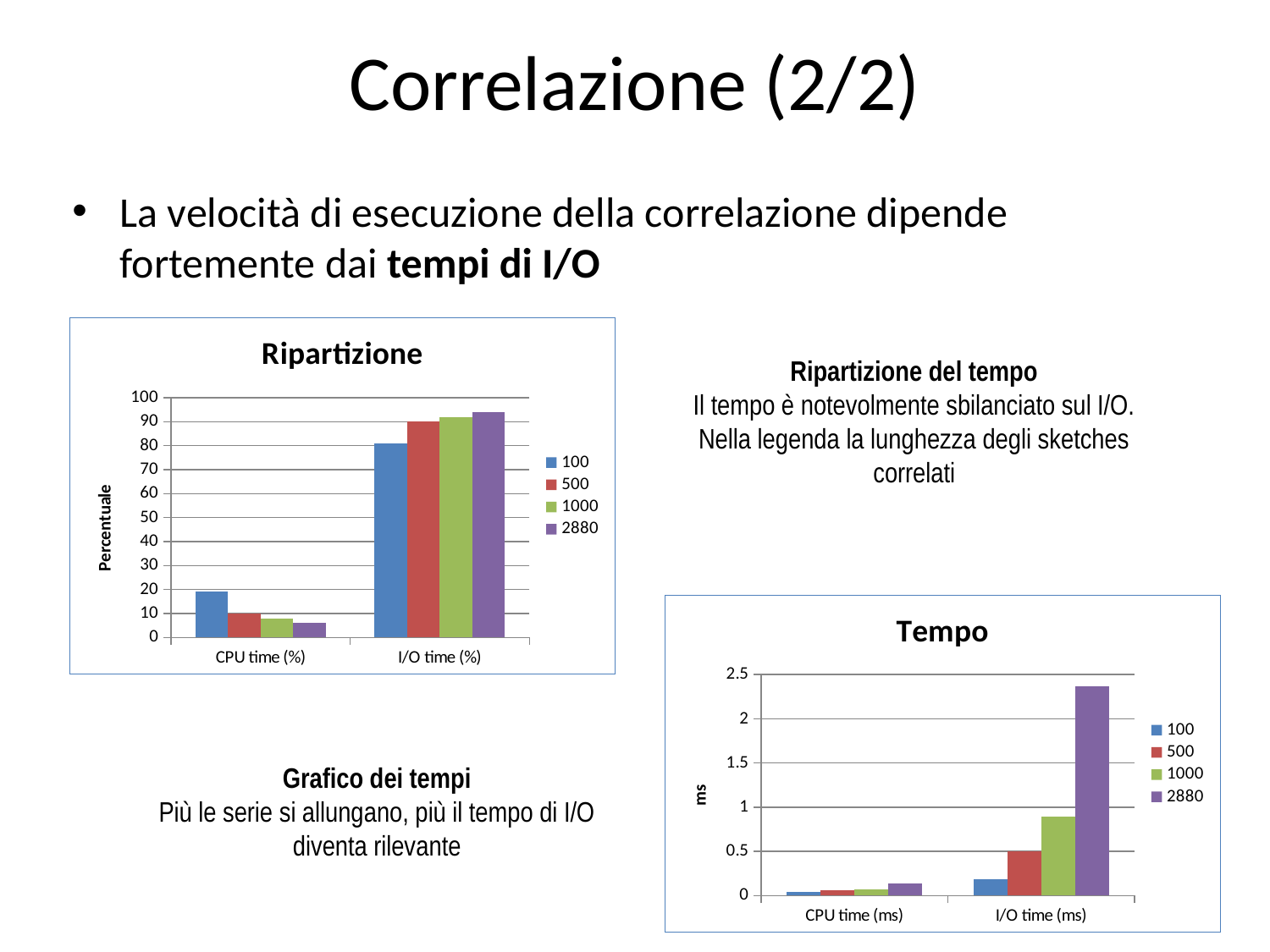
In the "Tempo" chart, is the value of the 2880 series for I/O time (ms) greater or less than 2? greater In the "Ripartizione" chart, which series has the lowest value for I/O time (%)? 100 In the "Ripartizione" chart, what is the label of the y axis? Percentuale In the "Ripartizione" chart, which series has the highest value for CPU time (%)? 100 In the "Ripartizione" chart, is the value of the 2880 series for I/O time (%) greater or less than 90? greater In the "Tempo" chart, what is the label of the y axis? ms In the "Tempo" chart, is the value of the 500 series for I/O time (ms) larger than the value of the 100 series for I/O time (ms)? Yes In the "Tempo" chart, which series has the highest value for I/O time (ms)? 2880 In the "Ripartizione" chart, how many series does the legend list? 4 In the "Ripartizione" chart, what kind of chart is shown? bar chart In the "Ripartizione" chart, is the value of the 100 series for CPU time (%) greater or less than 10? greater In the "Ripartizione" chart, how many categories are shown on the x axis? 2